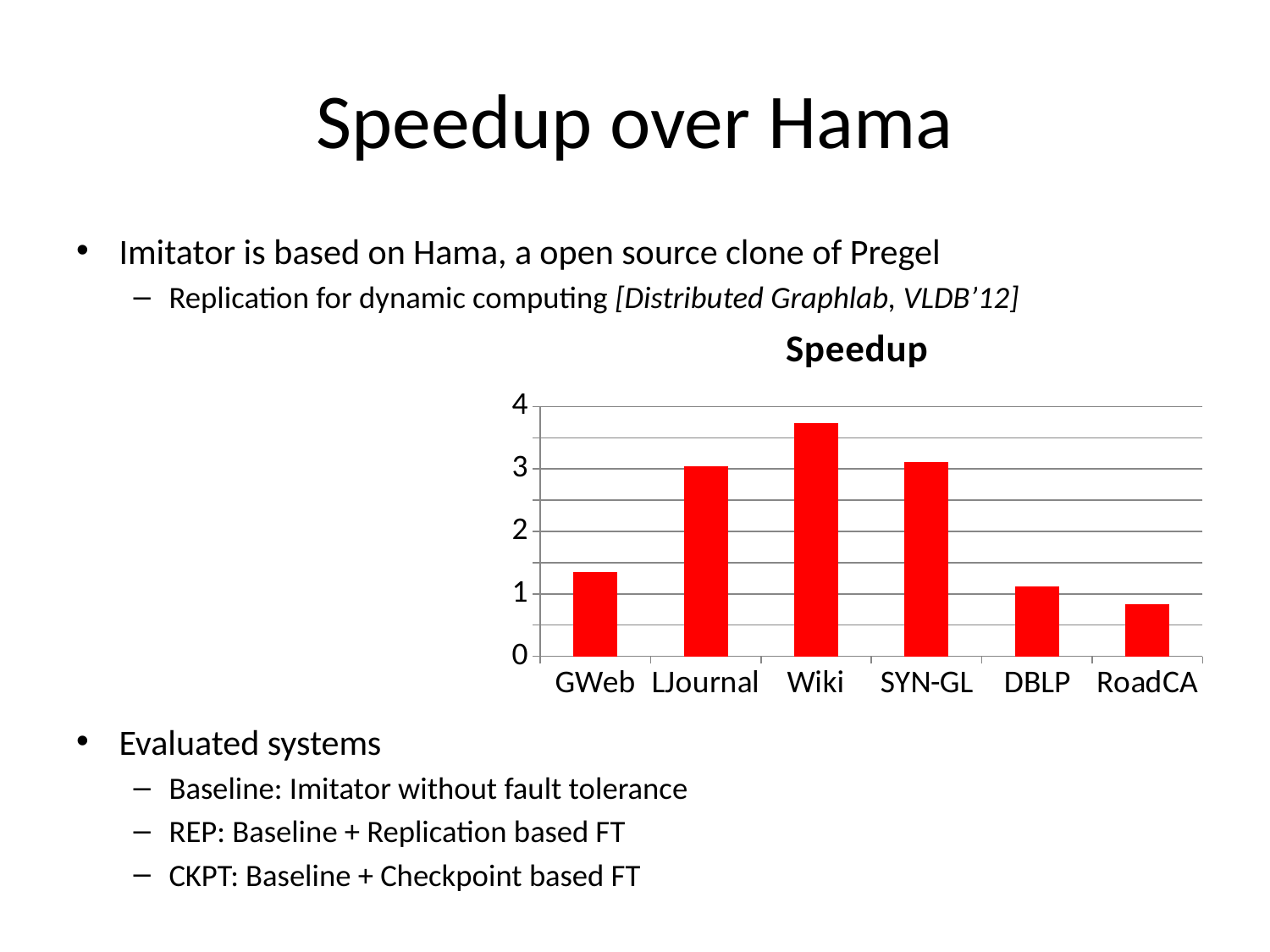
How many categories are plotted on the x axis of the chart? 6 Is the value for Wiki greater or less than 3? greater Which category has the lowest speedup in the chart? RoadCA Is the value for GWeb greater or less than 1? greater What is the title of the chart? Speedup Which is larger, the value for Wiki or the value for DBLP? Wiki What colour are the bars in the chart? red What kind of chart is shown on the slide? bar chart Is the value for RoadCA greater or less than 1? less Which category has the highest speedup in the chart? Wiki